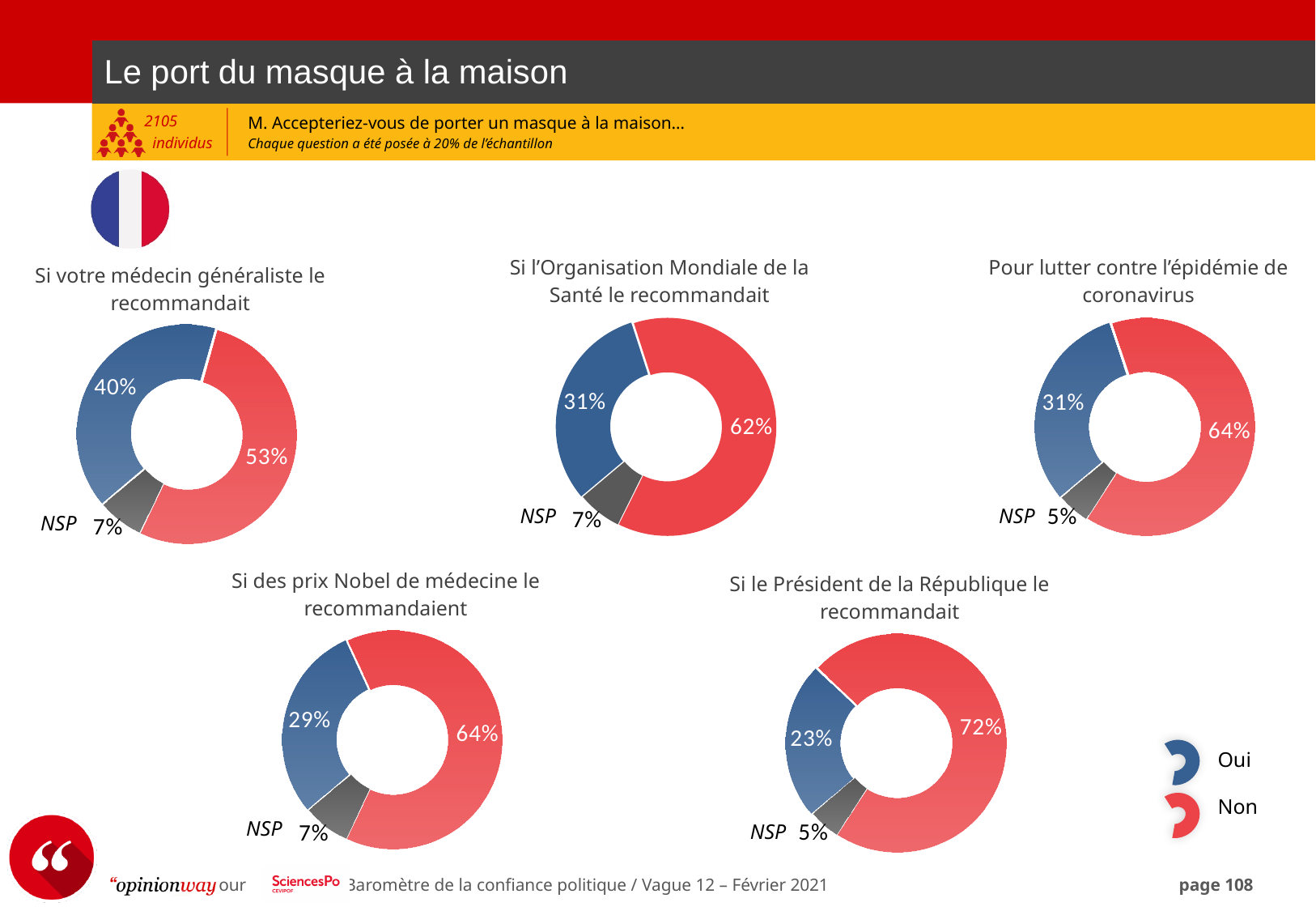
Across the five charts, which scenario has the highest Oui share? Si votre médecin généraliste le recommandait In the chart 'Si l'Organisation Mondiale de la Santé le recommandait', which is larger, Oui or Non? Non Across the five charts, which scenario has the highest Non share? Si le Président de la République le recommandait In the chart 'Si votre médecin généraliste le recommandait', what percentage answered Oui? 40% In the chart 'Pour lutter contre l'épidémie de coronavirus', what is the NSP share? 5% According to the legend, which colour represents Oui? Blue In the chart 'Si votre médecin généraliste le recommandait', what percentage answered Non? 53% What type of chart is used on this slide? Donut (pie) chart In the chart 'Si des prix Nobel de médecine le recommandaient', what is the difference between the Non and Oui shares? 35 percentage points How many donut charts are shown on the slide? 5 In the chart 'Si le Président de la République le recommandait', what percentage answered Oui? 23% In the chart 'Si l'Organisation Mondiale de la Santé le recommandait', what is the Non share? 62%